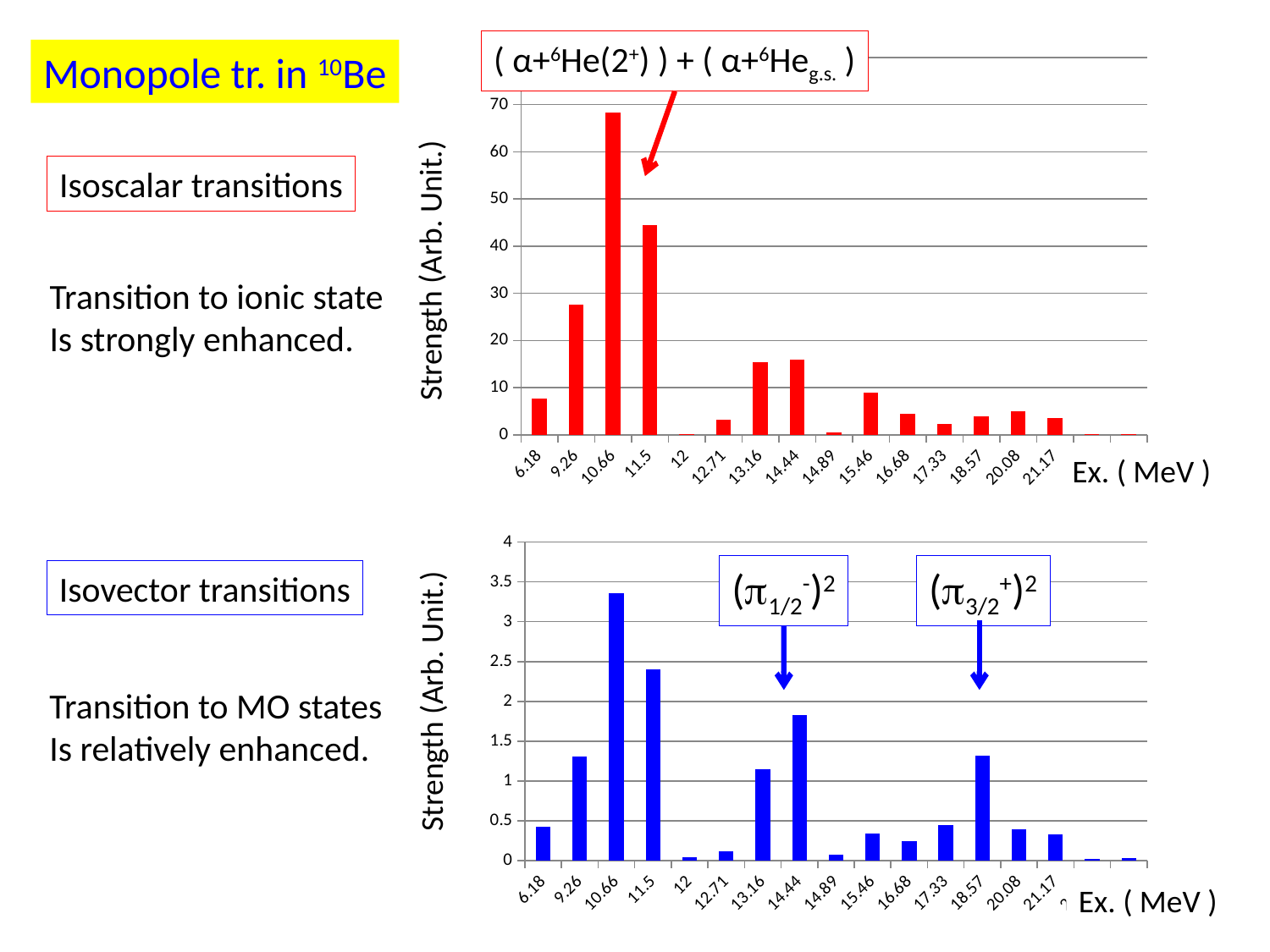
In the bottom (blue) chart, is the value for 18.57 greater or less than 1? greater What is the y-axis label of the top (red) chart? Strength (Arb. Unit.) In the top (red) chart, which has the larger value, 9.26 or 11.5? 11.5 In the bottom (blue) chart, which excitation energy has the highest strength? 10.66 In the top (red) chart, is the value for 10.66 greater or less than 60? greater In the top (red) chart, is the value for 9.26 greater or less than 30? less In the top (red) chart, which excitation energy has the highest strength? 10.66 In the bottom (blue) chart, which has the larger value, 9.26 or 14.44? 14.44 What kind of chart is the top (red) chart on the slide? bar chart